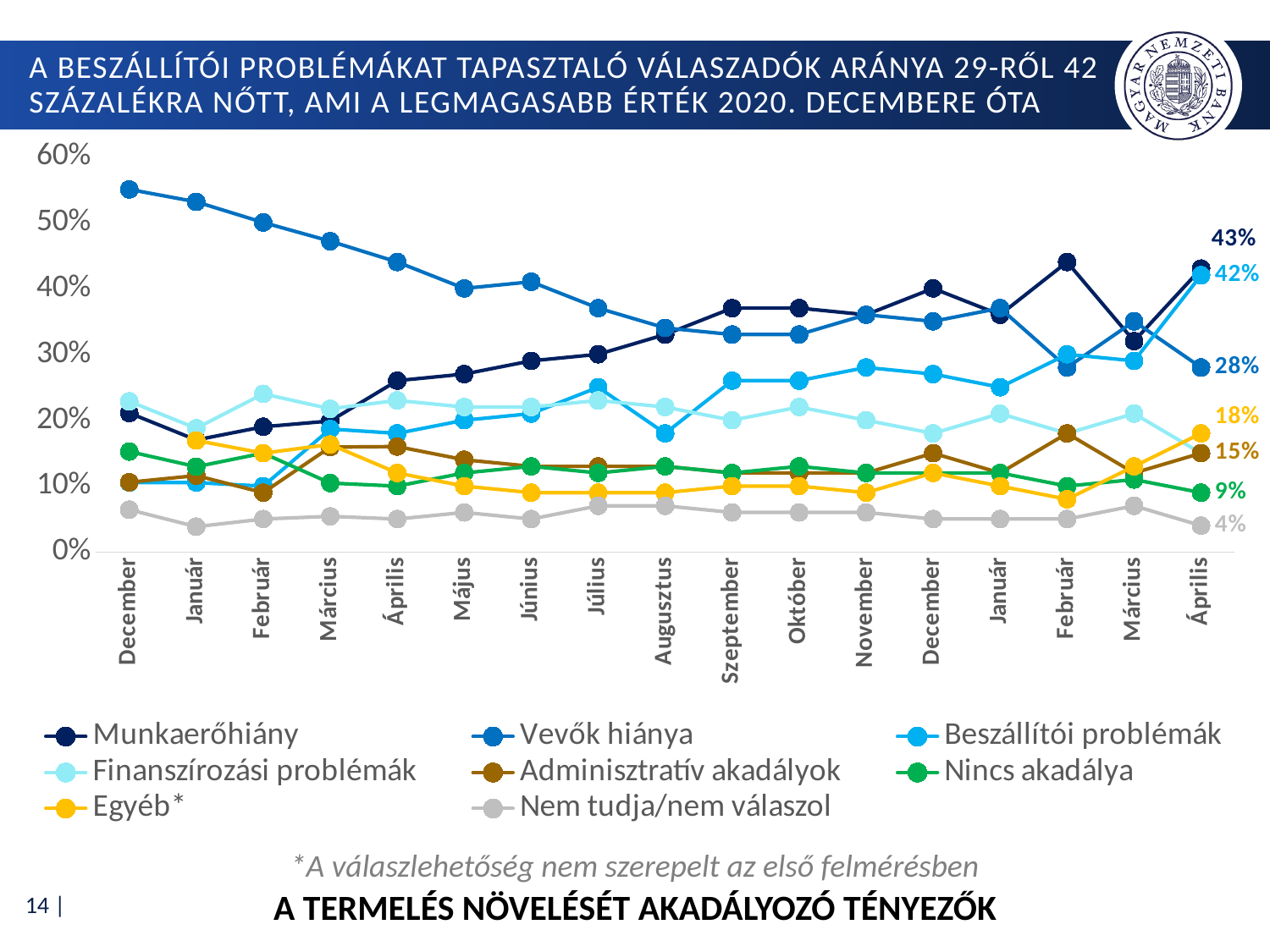
In the final Április, how many percentage points higher is Munkaerőhiány than Beszállítói problémák? 1 percentage point Does the Vevők hiánya series generally rise or fall from the first December to the final Április? Fall What is the value for Beszállítói problémák in the final Április? 42% What is the value for Nincs akadálya in the final Április? 9% What is the value for Vevők hiánya in the final Április? 28% How many series does the legend list? 8 Is the value for Vevők hiánya in the first December greater or less than 50%? greater What kind of chart is shown on the slide? Line chart What is the value for Munkaerőhiány in the final Április? 43% What is the value for Nem tudja/nem válaszol in the final Április? 4% How many months are shown along the x axis? 17 What is the value for Adminisztratív akadályok in the final Április? 15%